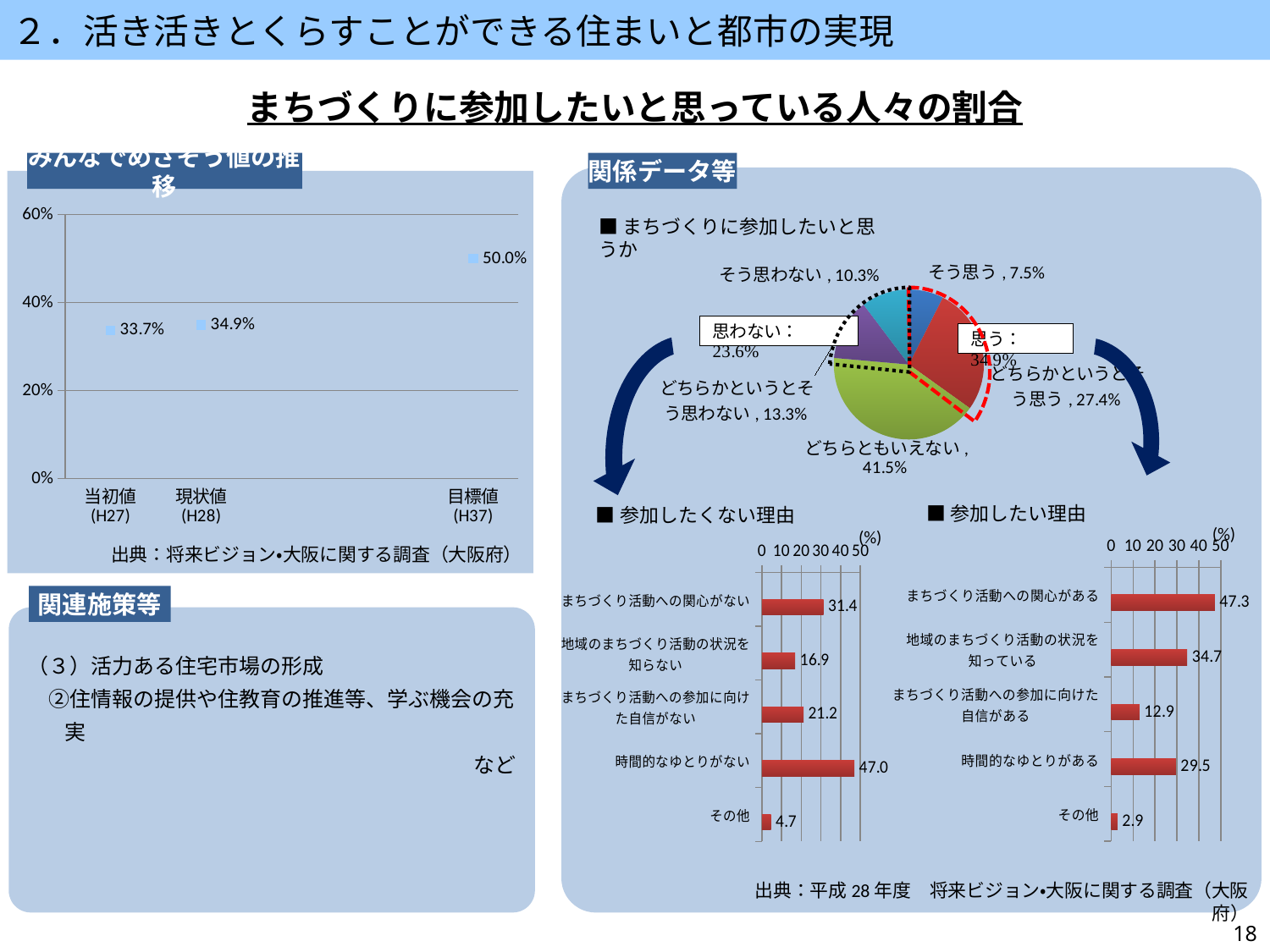
In the bar chart 参加したい理由, which reason has the lowest value? その他 In the pie chart まちづくりに参加したいと思うか, which slice is the largest? どちらともいえない In the bar chart 参加したくない理由, what is the value for まちづくり活動への参加に向けた自信がない? 21.2 In the pie chart まちづくりに参加したいと思うか, what is the combined share of そう思う and どちらかというとそう思う? 34.9% In the bar chart 参加したい理由, which is larger: 地域のまちづくり活動の状況を知っている or 時間的なゆとりがある? 地域のまちづくり活動の状況を知っている In the pie chart まちづくりに参加したいと思うか, how many slices are there? 5 In the chart titled みんなでめざそう値の推移, what is the value for 当初値 (H27)? 33.7% In the bar chart 参加したくない理由, which reason has the highest value? 時間的なゆとりがない In the chart titled みんなでめざそう値の推移, what is the difference between the 目標値 (H37) and the 当初値 (H27)? 16.3 percentage points In the pie chart まちづくりに参加したいと思うか, what share does どちらともいえない have? 41.5% In the chart titled みんなでめざそう値の推移, do the values rise or fall from 当初値 (H27) to 目標値 (H37)? rise In the chart titled みんなでめざそう値の推移, what is the value for 目標値 (H37)? 50.0%